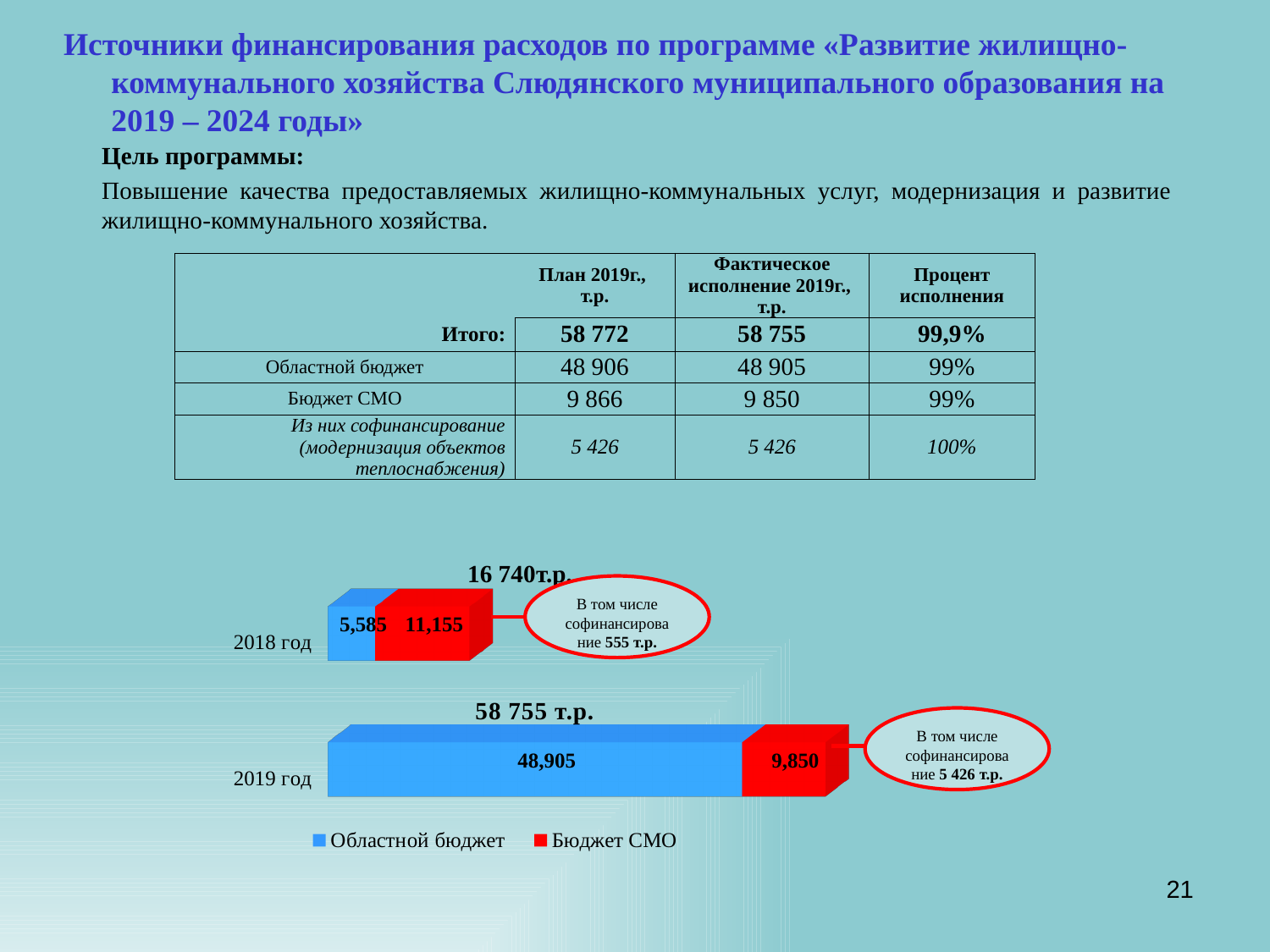
Which year has the larger total bar in the chart? 2019 год What is the value of Бюджет СМО for 2019 год in the chart? 9,850 What is the total of the stacked bar for 2018 год? 16 740 т.р. What is the difference between Областной бюджет and Бюджет СМО for 2019 год? 39,055 What is the total of the stacked bar for 2019 год? 58 755 т.р. What is the value of Областной бюджет for 2018 год in the chart? 5,585 What is the value of Областной бюджет for 2019 год in the chart? 48,905 In 2018 год, which is larger: Областной бюджет or Бюджет СМО? Бюджет СМО How many categories (years) are plotted in the chart? 2 What is the value of Бюджет СМО for 2018 год in the chart? 11,155 What kind of chart is shown on the slide? Stacked bar chart How many series does the chart legend list? 2